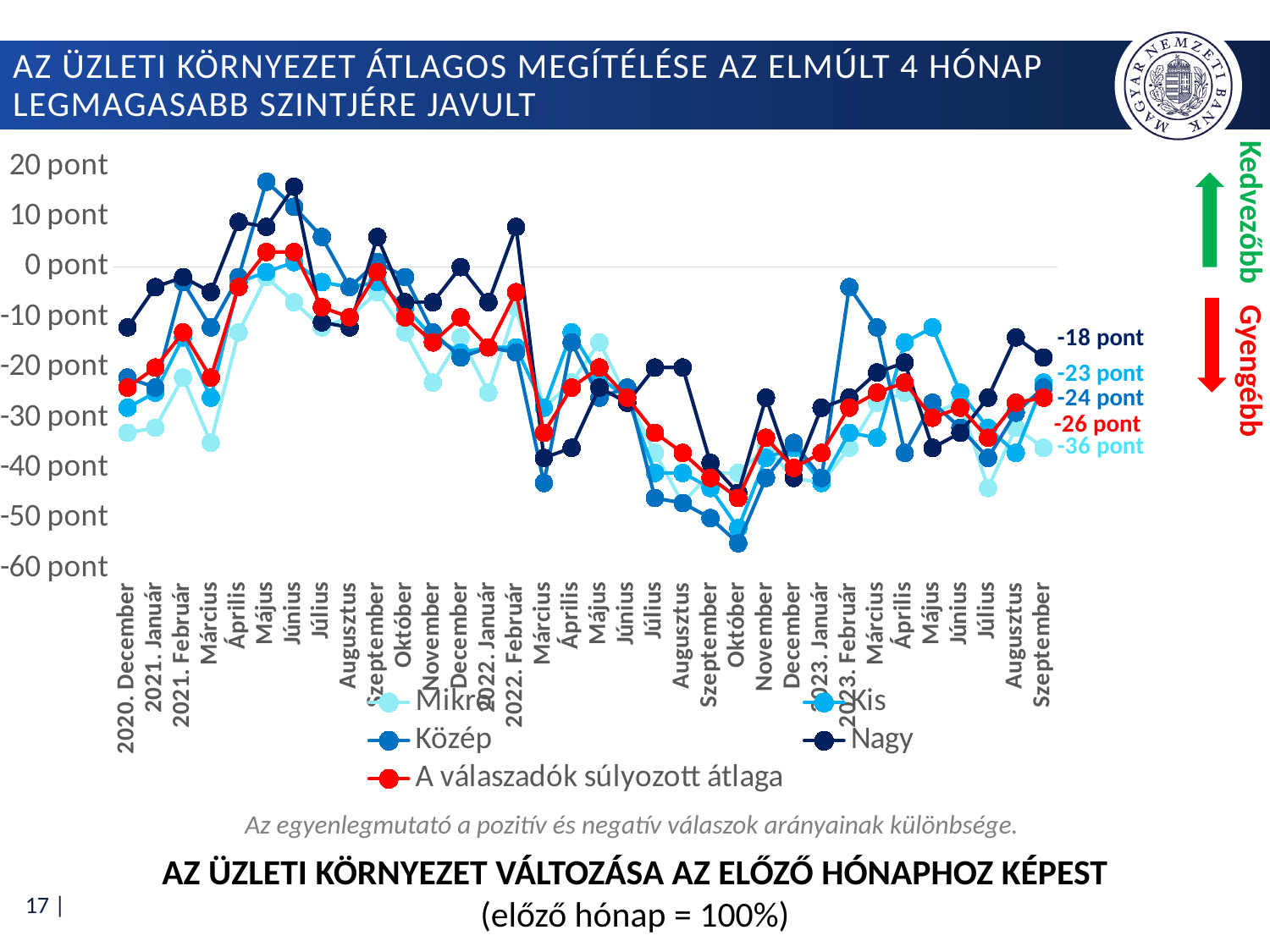
What is the value labelled at the end of the 'A válaszadók súlyozott átlaga' series (2023 September)? -26 pont What is the value labelled at the end of the Nagy series (2023 September)? -18 pont How many months are shown on the x axis? 34 Is the value of 'A válaszadók súlyozott átlaga' in 2022 Október greater or less than -40 pont? less What kind of chart is shown on the slide? line chart Which series has the highest value in 2023 September? Nagy How many series does the legend list? 5 Which series has the lowest value in 2023 September? Mikro In 2023 September, which is larger: the Kis value or the Mikro value? Kis What is the value labelled at the end of the Mikro series (2023 September)? -36 pont Does the 'A válaszadók súlyozott átlaga' series rise or fall between 2021 Június and 2022 Október? fall What is the difference between the Nagy and Mikro values in 2023 September? 18 pont